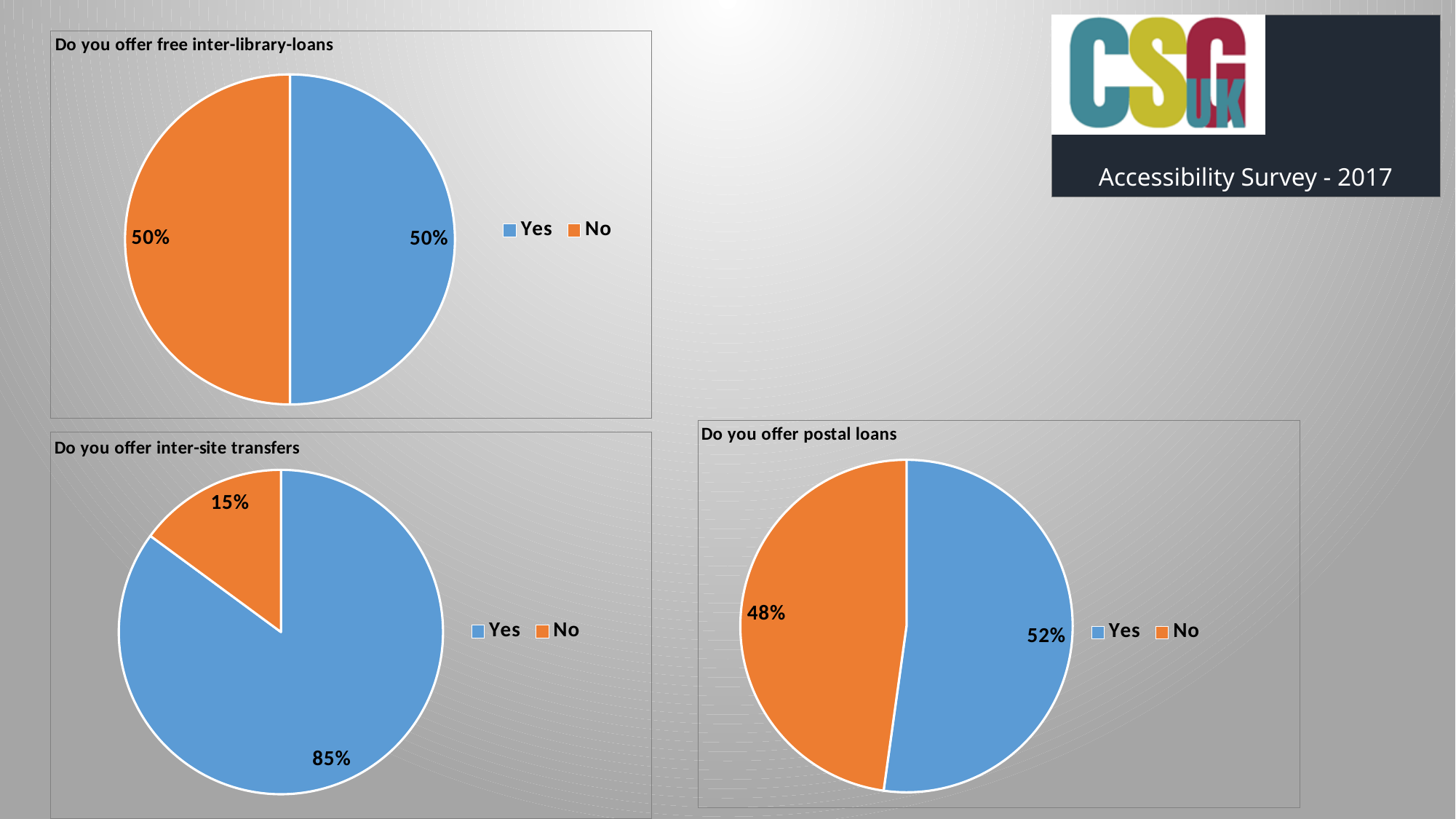
In the 'Do you offer free inter-library-loans' chart, what percentage answered Yes? 50% In the 'Do you offer inter-site transfers' chart, what percentage answered Yes? 85% In the 'Do you offer postal loans' chart, what percentage answered Yes? 52% In the 'Do you offer inter-site transfers' chart, what percentage answered No? 15% In the 'Do you offer postal loans' chart, which response has the smallest slice? No In the 'Do you offer inter-site transfers' chart, which response has the largest slice? Yes How many categories does the legend of the 'Do you offer postal loans' chart list? 2 What type of chart is used for 'Do you offer free inter-library-loans'? Pie chart In the 'Do you offer postal loans' chart, what is the difference between the Yes and No percentages? 4% In the 'Do you offer inter-site transfers' chart, which colour represents No? Orange In the 'Do you offer postal loans' chart, what percentage answered No? 48% In the 'Do you offer inter-site transfers' chart, what is the difference between the Yes and No percentages? 70%